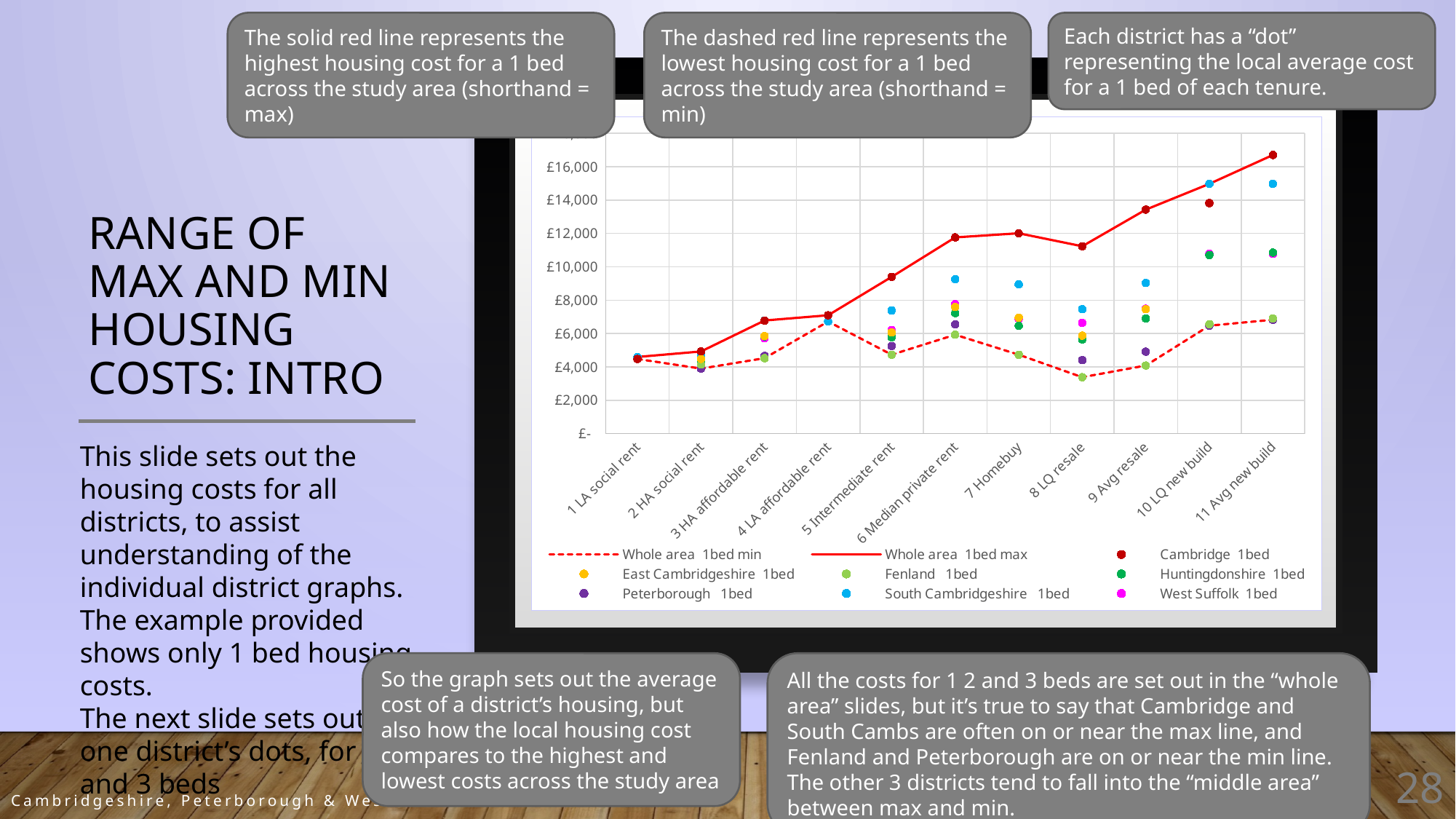
Is the South Cambridgeshire 1bed value at 10 LQ new build greater or less than £14,000? greater Is the Fenland 1bed value at 11 Avg new build greater or less than £8,000? less At which category does the Whole area 1bed max line reach its highest value? 11 Avg new build What kind of chart is shown on the slide? line chart At which category does the Whole area 1bed min line reach its lowest value? 8 LQ resale How many series does the chart's legend list? 9 At 7 Homebuy, which is larger: the Cambridge 1bed value or the Fenland 1bed value? Cambridge 1bed Is the value of the Whole area 1bed max line at 11 Avg new build greater or less than £16,000? greater Does the Whole area 1bed max line generally rise or fall from 1 LA social rent to 11 Avg new build? rise How many categories are shown along the x axis of the chart? 11